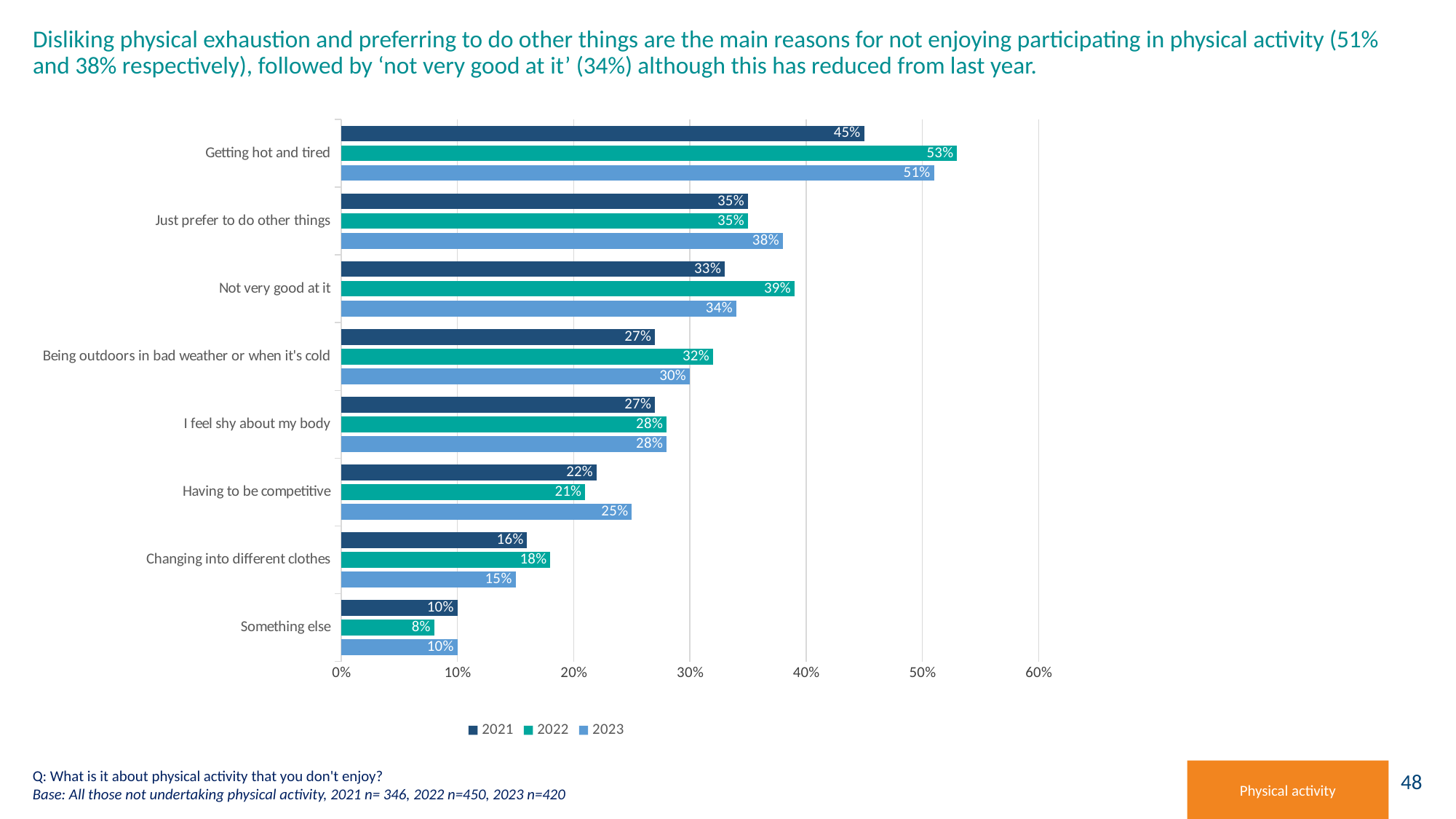
Which category has the highest 2022 value? Getting hot and tired How many series does the legend list? 3 Which years are listed in the chart legend? 2021, 2022, 2023 What is the difference between the 2021 and 2022 values for 'Getting hot and tired'? 8% Which is larger for 'Changing into different clothes': the 2022 value or the 2023 value? 2022 What is the difference between the 2022 and 2023 values for 'Not very good at it'? 5% How many categories are shown on the chart? 8 Which category has the lowest 2023 value? Something else What is the 2021 value for 'Having to be competitive'? 22% What kind of chart is shown on the slide? Bar chart What is the 2022 value for 'Not very good at it'? 39% What is the 2023 value for 'Getting hot and tired'? 51%